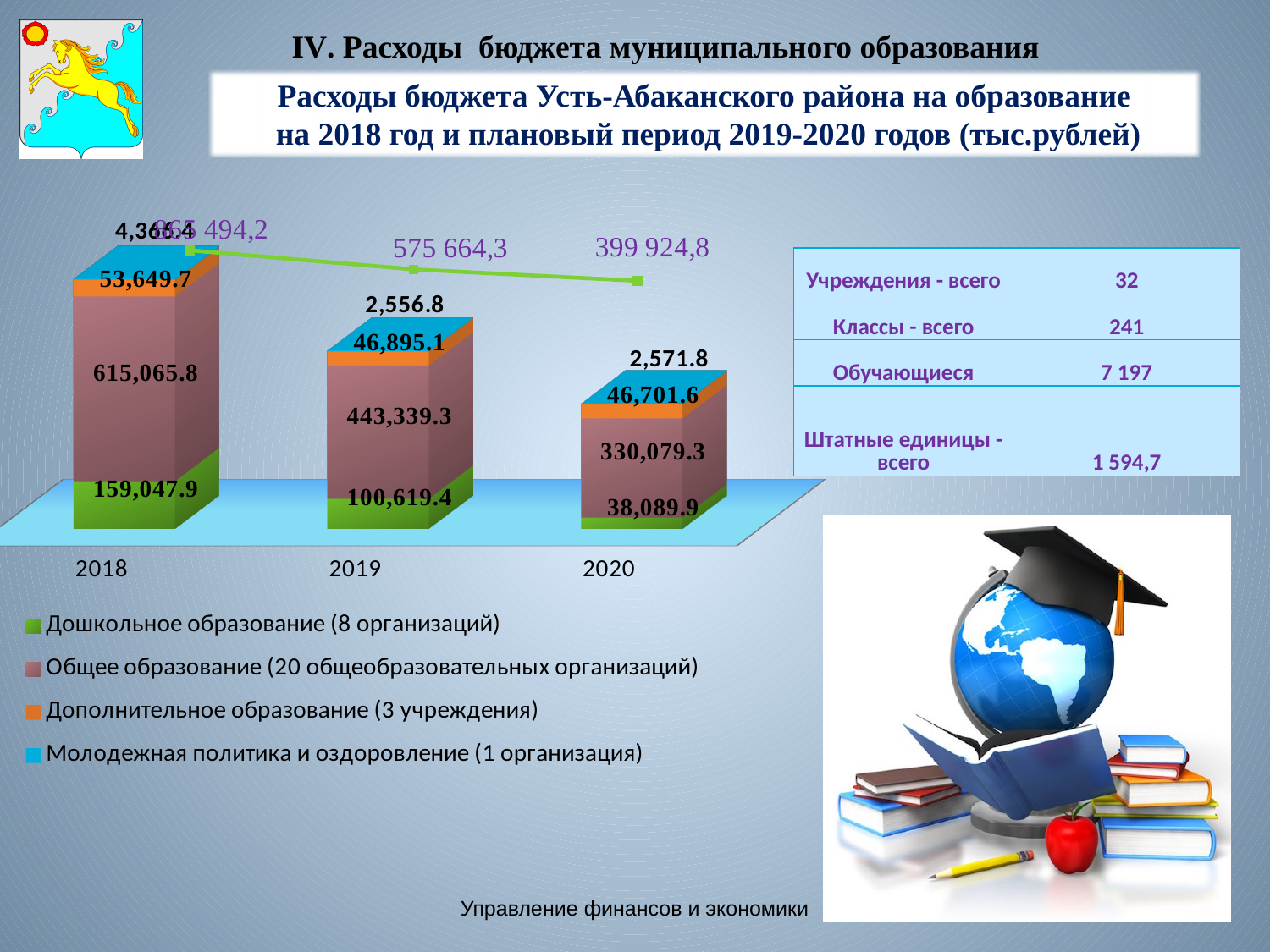
What is the value for Дошкольное образование in 2019? 100,619.4 In which year is the value for Общее образование the highest? 2018 What is the difference between the Дошкольное образование values for 2018 and 2020? 120,958.0 What kind of chart is used to show the education expenditures? Stacked bar chart Which year has the larger value for Дополнительное образование, 2019 or 2020? 2019 How many series does the chart legend list? 4 In which year is the value for Дошкольное образование the lowest? 2020 What is the value for Молодежная политика и оздоровление in 2019? 2,556.8 What is the total of the stacked bar for 2019? 593,410.6 What is the value for Общее образование in 2018? 615,065.8 How many years are shown on the x axis of the chart? 3 What is the value for Дополнительное образование in 2020? 46,701.6